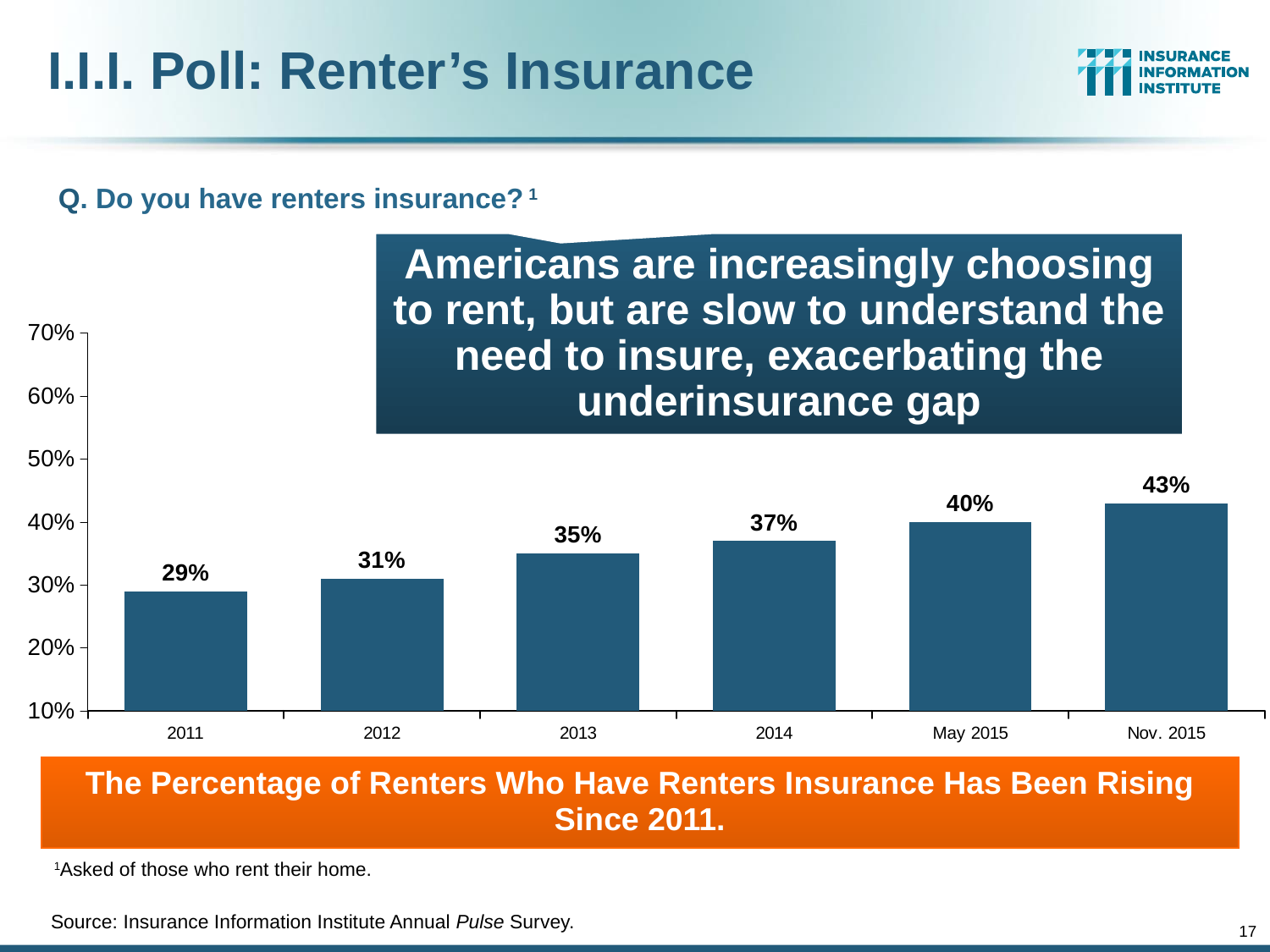
What is the difference between the 2014 value and the 2012 value? 6 percentage points Is the value for 2014 greater or less than 30%? greater Do the values rise or fall from 2011 to Nov. 2015? Rise What is the value shown for 2013? 35% What kind of chart is shown on the slide? Bar chart Which period has the highest percentage of renters with renters insurance? Nov. 2015 What is the value shown for May 2015? 40% What percentage of renters had renters insurance in 2011? 29% Which is larger, the value for 2013 or the value for May 2015? May 2015 How many time periods are shown on the x axis? 6 Which period has the lowest percentage of renters with renters insurance? 2011 What is the difference between the Nov. 2015 value and the 2011 value? 14 percentage points